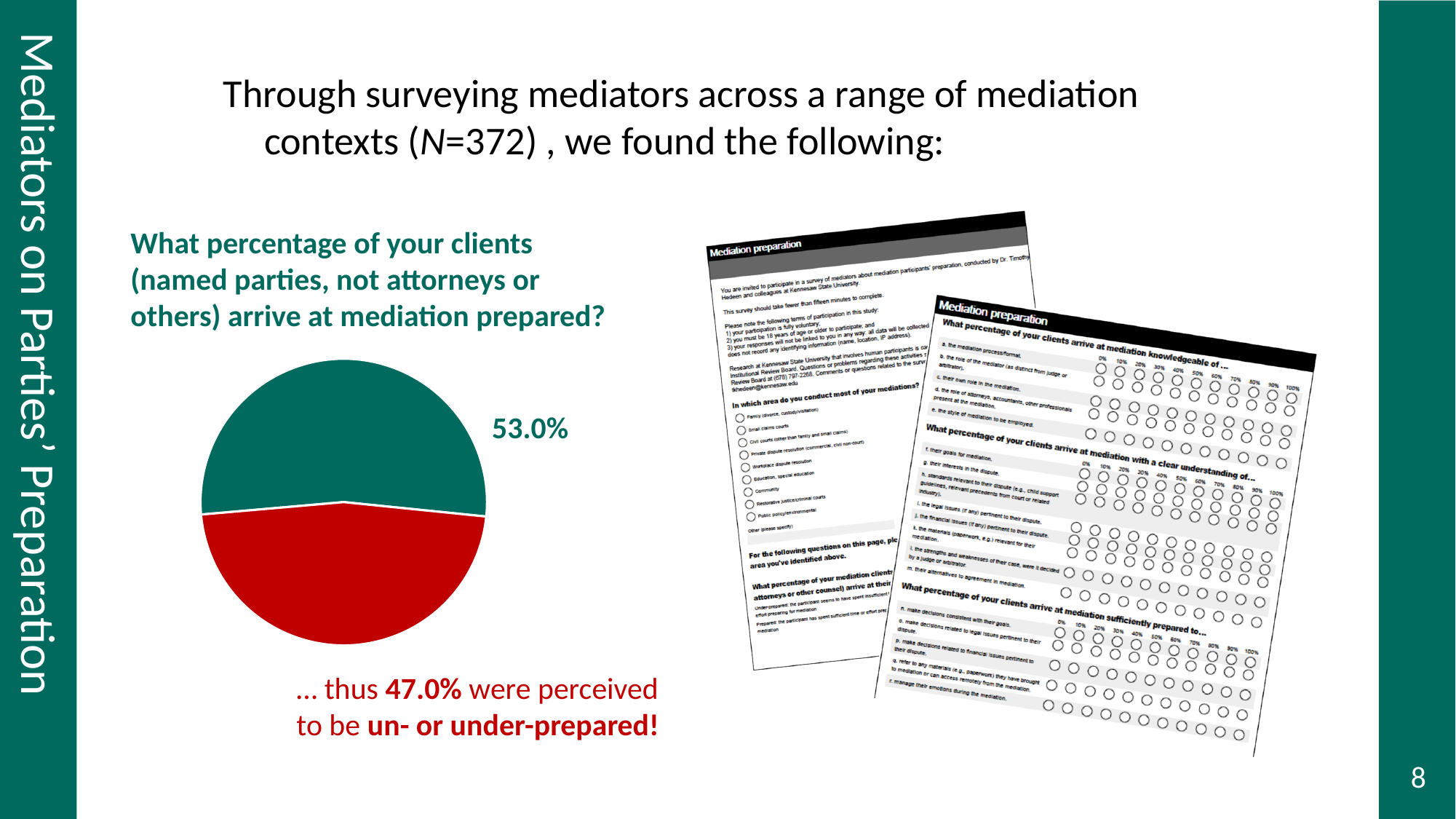
What is the difference between the green slice (53.0%) and the red slice (47.0%) of the pie chart? 6.0% Is the green slice of the pie chart greater or less than 50%? greater Is the red slice of the pie chart greater or less than 50%? less Which slice of the pie chart is larger, the green one or the red one? green According to the slide, what percentage of clients were perceived to be un- or under-prepared (the red slice)? 47.0% What colour is the slice representing clients perceived to be un- or under-prepared? red What share of the pie does the slice representing clients who arrive prepared take up? 53.0% What percentage is labelled on the green slice of the pie chart? 53.0% How many slices does the pie chart have? 2 What kind of chart is shown on the slide? pie chart What question does the pie chart answer, according to the green heading above it? What percentage of your clients (named parties, not attorneys or others) arrive at mediation prepared? What is the sample size (N) of the mediator survey stated on the slide? 372